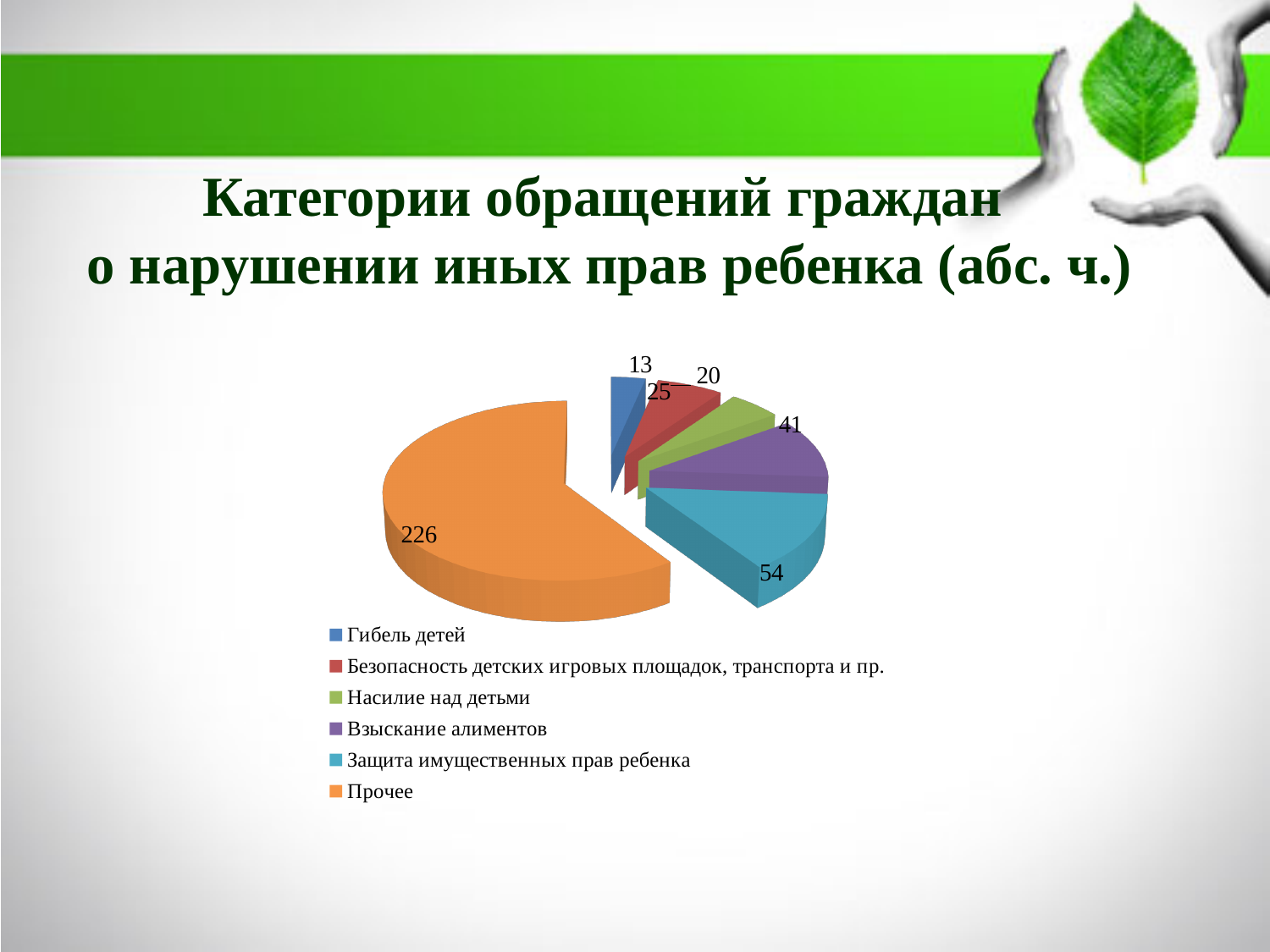
What is the difference between the values for "Прочее" and "Защита имущественных прав ребенка"? 172 What is the value for "Гибель детей"? 13 What is the value for "Прочее"? 226 What is the value for "Защита имущественных прав ребенка"? 54 Which category has the largest slice of the pie? Прочее Which category has the smallest slice of the pie? Гибель детей Which is larger: the value for "Безопасность детских игровых площадок, транспорта и пр." or the value for "Насилие над детьми"? Безопасность детских игровых площадок, транспорта и пр. What type of chart is shown on the slide? Pie chart What is the value for "Взыскание алиментов"? 41 How many categories does the legend of the pie chart list? 6 What colour is the slice for "Взыскание алиментов"? Purple What is the value for "Насилие над детьми"? 20